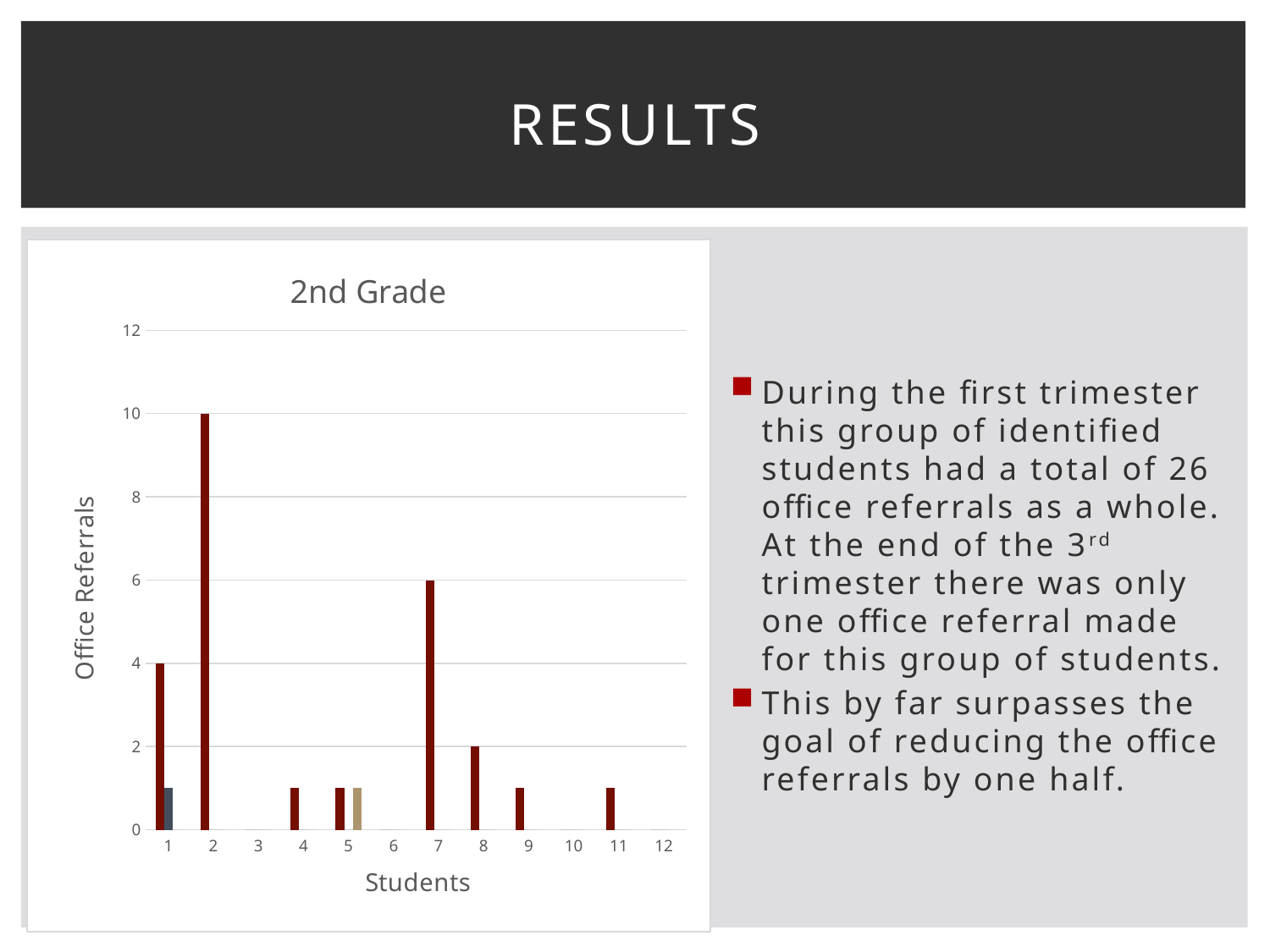
How many office referrals does student 2 have? 10 How many office referrals does student 8 have? 2 Which student has more office referrals, student 7 or student 8? 7 What is the label of the vertical axis of the chart? Office Referrals What type of chart is shown on the slide? bar chart How many office referrals does student 7 have? 6 Is the value for student 2 greater or less than 8? greater Is the value for student 4 greater or less than 2? less What is the title of the chart? 2nd Grade Which student has the highest number of office referrals? 2 What is the difference in office referrals between student 2 and student 7? 4 How many students are listed along the x axis of the chart? 12